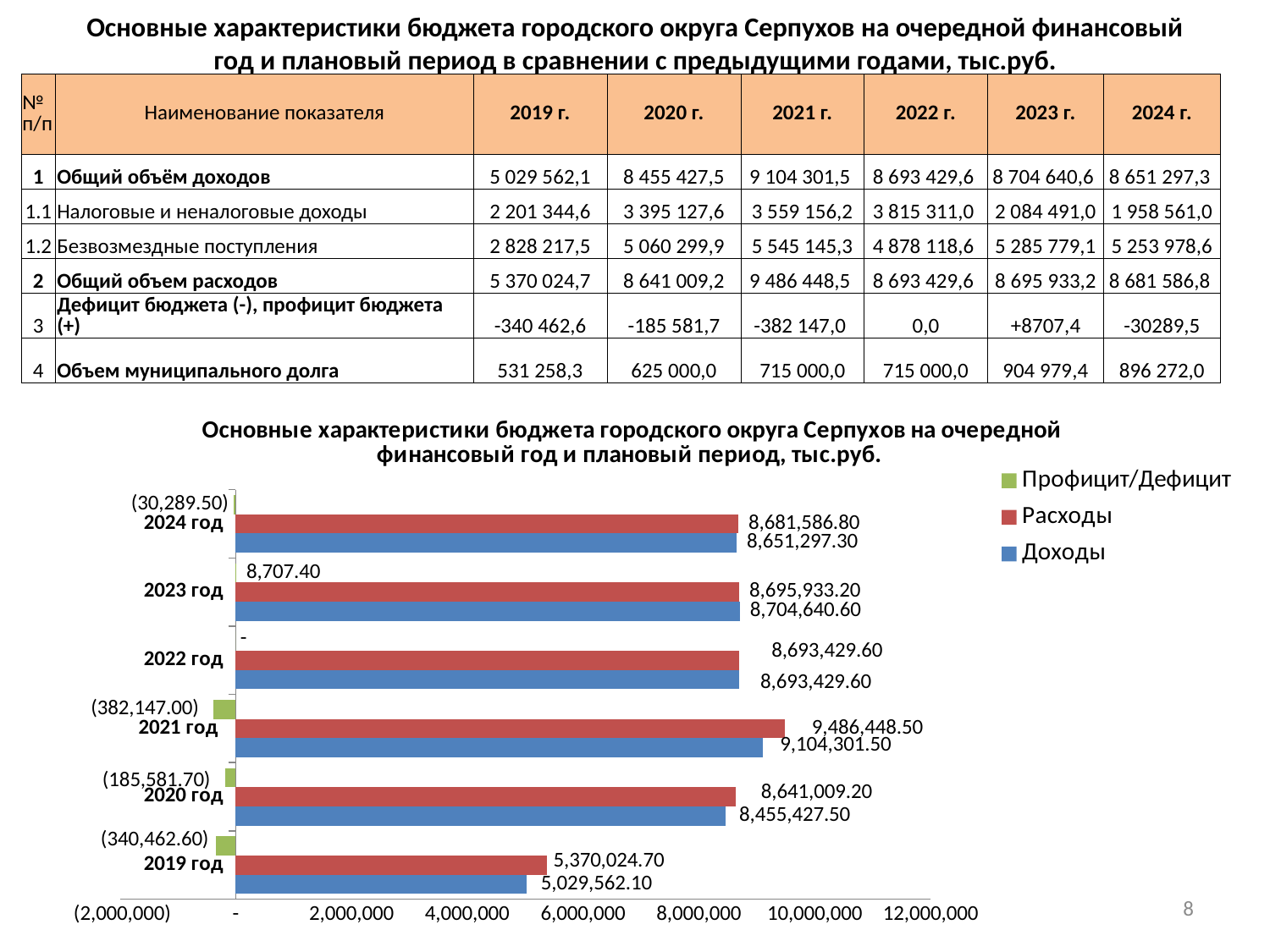
How many series does the chart legend list? 3 Which is larger for 2020 год on the chart: Расходы or Доходы? Расходы What is the difference between Расходы and Доходы for 2021 год on the chart? 382,147.00 What is the value of Профицит/Дефицит for 2023 год on the chart? 8,707.40 Is the value of Доходы for 2019 год greater or less than 6,000,000? less How many years (categories) are plotted on the chart? 6 Which year has the highest value of Расходы on the chart? 2021 год Which series is shown in green on the chart? Профицит/Дефицит Which year has the lowest value of Доходы on the chart? 2019 год What is the value of Доходы for 2019 год on the chart? 5,029,562.10 What is the value of Расходы for 2021 год on the chart? 9,486,448.50 What type of chart is shown on the slide? bar chart